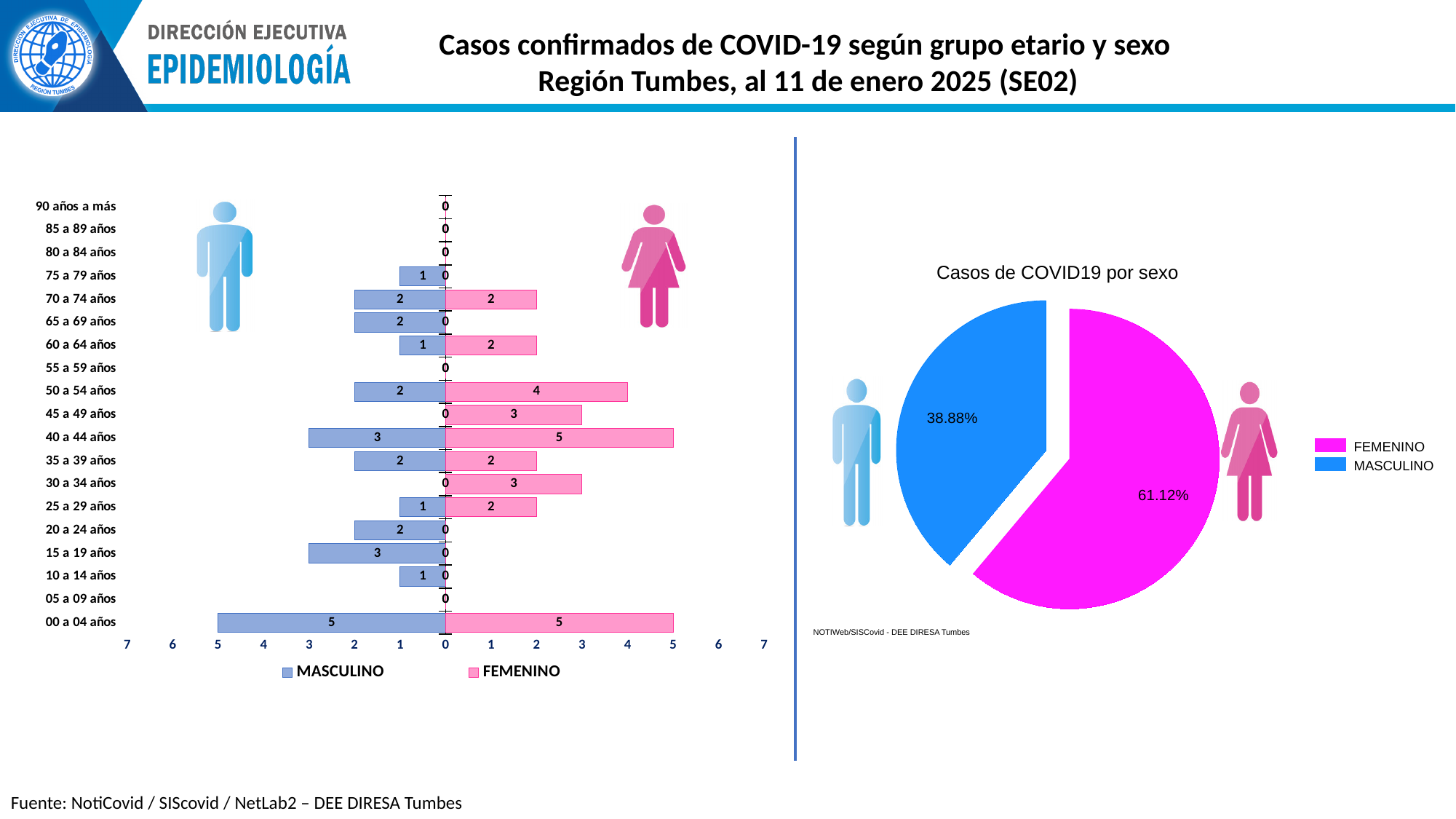
In the left bar chart, what is the MASCULINO value for the 15 a 19 años age group? 3 In the left bar chart, what is the FEMENINO value for the 40 a 44 años age group? 5 In the left bar chart, what is the difference between the FEMENINO and MASCULINO values for the 40 a 44 años age group? 2 In the left bar chart, how many age groups are listed on the vertical axis? 19 In the pie chart 'Casos de COVID19 por sexo', which slice is the largest? FEMENINO In the left bar chart, what is the FEMENINO value for the 50 a 54 años age group? 4 How many series does the legend of the left bar chart list? 2 In the left bar chart, which is larger for the 50 a 54 años age group, the MASCULINO or the FEMENINO value? FEMENINO In the pie chart 'Casos de COVID19 por sexo', what share does MASCULINO have? 38.88% In the left bar chart, what is the MASCULINO value for the 00 a 04 años age group? 5 What kind of chart is the chart on the left of the slide? Bar chart In the pie chart 'Casos de COVID19 por sexo', what share does FEMENINO have? 61.12%